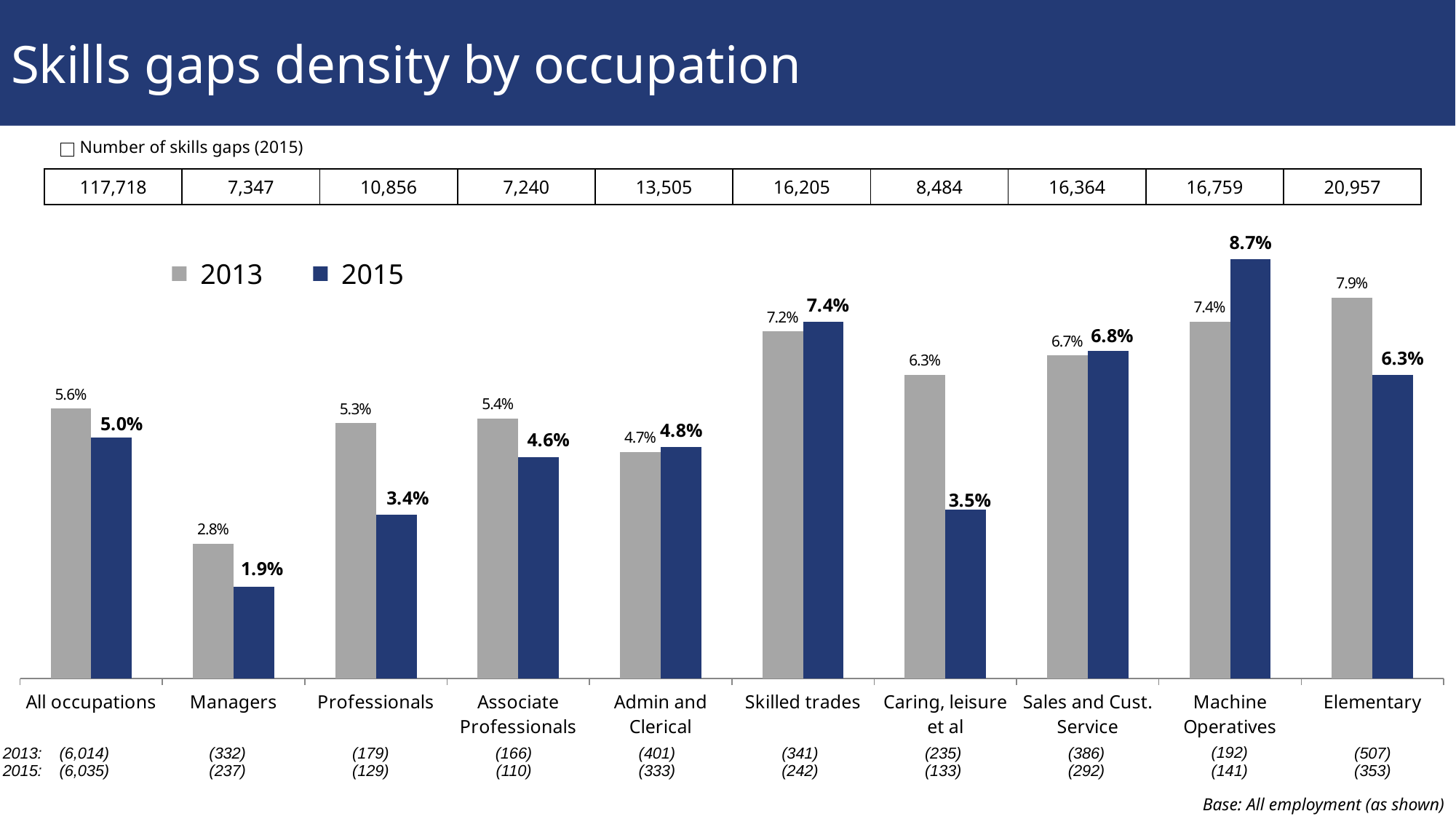
Which occupation has the lowest 2013 skills gap density? Managers What is the 2015 skills gap density for Elementary occupations? 6.3% Which occupation has the highest 2015 skills gap density? Machine Operatives What kind of chart is shown on the slide? Bar chart What is the difference between the 2013 and 2015 skills gap density for Caring, leisure et al? 2.8 percentage points What is the 2013 skills gap density for Skilled trades? 7.2% What is the 2015 skills gap density for Managers? 1.9% What is the number of skills gaps (2015) shown for Elementary occupations? 20,957 Which colour represents the 2015 series in the legend? Dark blue How many occupation categories are shown on the x axis? 10 How many series does the legend list? 2 Which is larger for Professionals: the 2013 value or the 2015 value? 2013